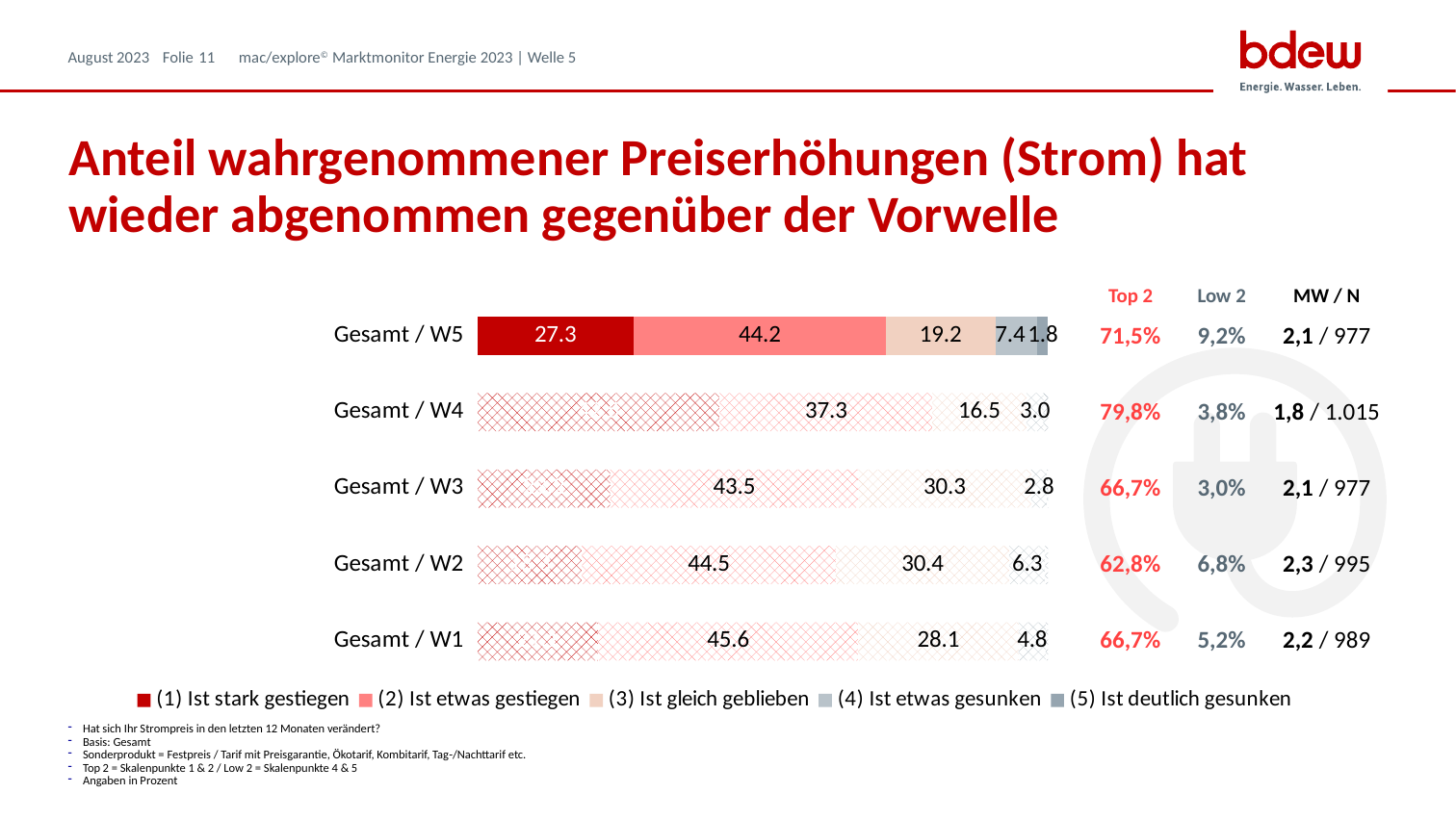
How many series does the legend list? 5 What is the value of "(2) Ist etwas gestiegen" for Gesamt / W1? 45.6 What kind of chart is shown on the slide? stacked bar chart What is the value of "(2) Ist etwas gestiegen" for Gesamt / W5? 44.2 What is the Top 2 value shown for Gesamt / W4? 79,8% What is the Low 2 value shown for Gesamt / W5? 9,2% Which wave has the highest Top 2 value? Gesamt / W4 How many categories (waves) are plotted in the chart? 5 What is the value of "(3) Ist gleich geblieben" for Gesamt / W3? 30.3 Which is larger: the "(2) Ist etwas gestiegen" value for Gesamt / W2 or for Gesamt / W4? Gesamt / W2 What is the difference between the "(3) Ist gleich geblieben" values for Gesamt / W2 and Gesamt / W5? 11.2 What is the value of "(1) Ist stark gestiegen" for Gesamt / W5? 27.3